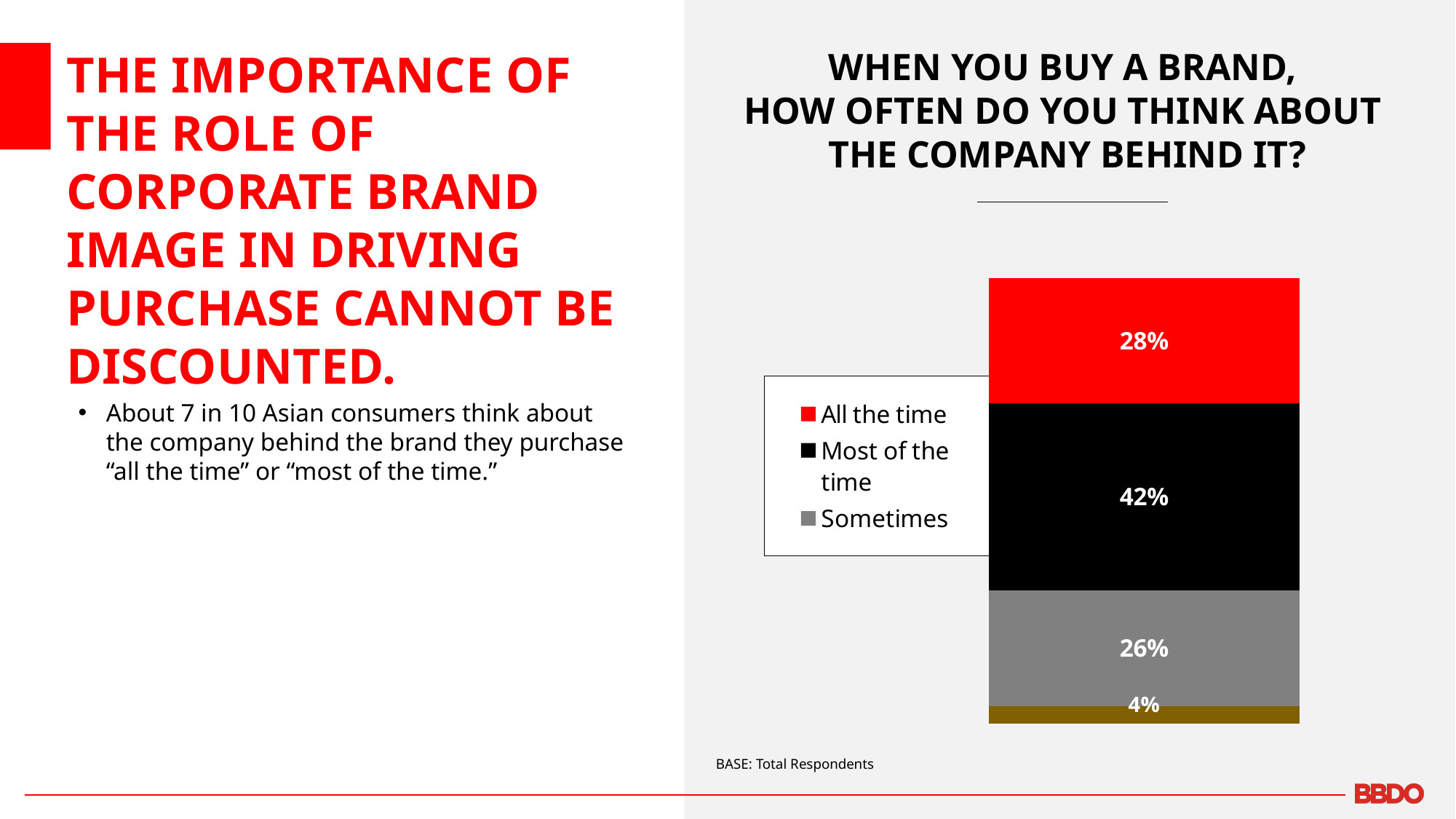
Which response category has the highest value in the chart? Most of the time What value is shown for "Sometimes"? 26% Which is larger, the value for "All the time" or for "Sometimes"? All the time What is the total of all the segments in the stacked bar? 100% How much larger is the value for "Most of the time" than for "All the time"? 14% What colour represents "All the time" in the chart? Red What is the smallest value labelled on the stacked bar? 4% What kind of chart is shown on the slide? Stacked bar chart How many entries does the chart legend list? 3 What is the combined value of "All the time" and "Most of the time"? 70% What value is shown for "Most of the time"? 42% What percentage of respondents think about the company behind the brand "All the time"? 28%